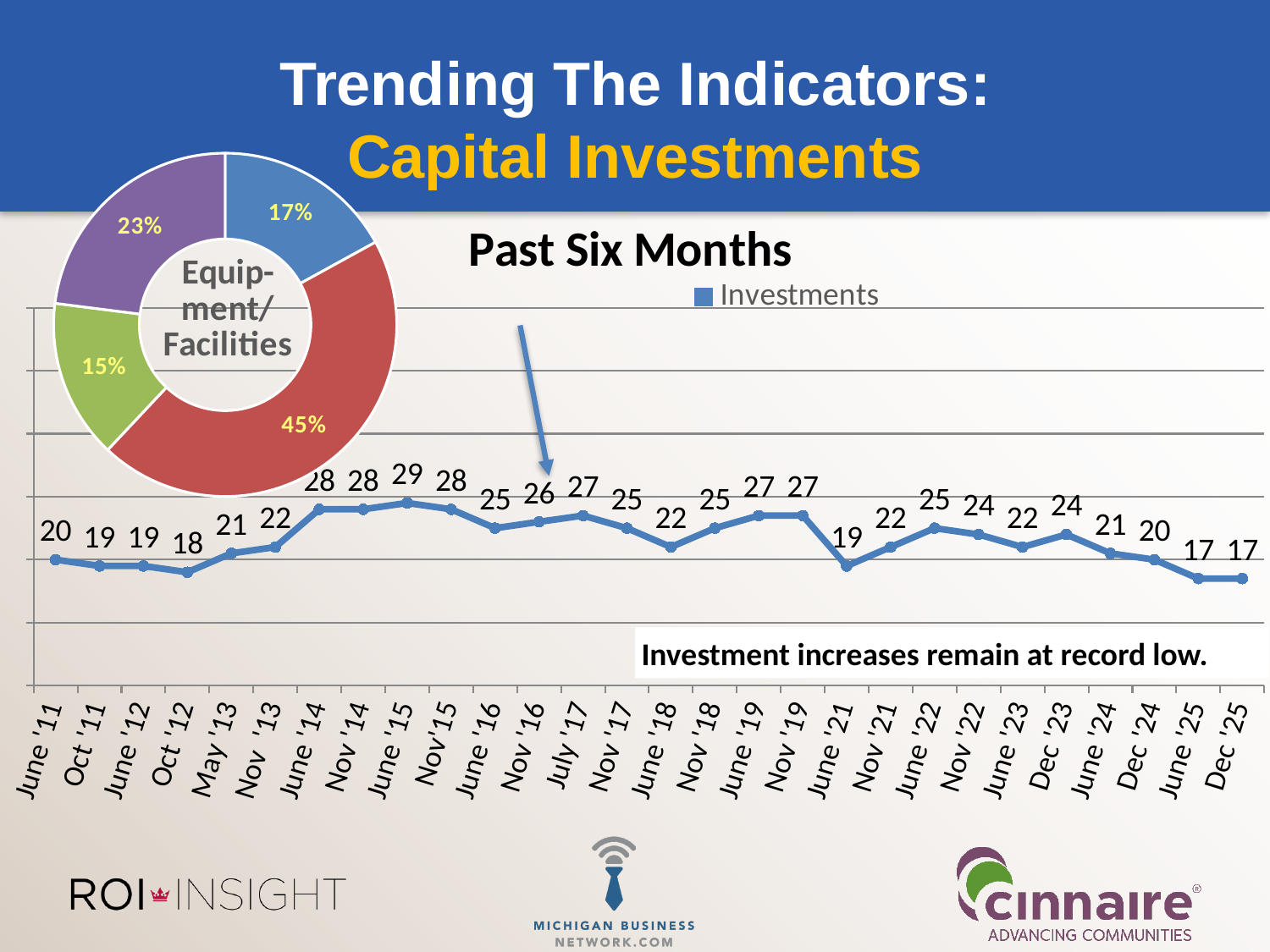
What kind of chart is the Past Six Months chart? Line chart In the Equipment/Facilities donut chart, what is the share of the largest slice? 45% In the Past Six Months line chart, how many data points are plotted? 28 In the Equipment/Facilities donut chart, what is the share of the smallest slice? 15% In the Past Six Months line chart, what is the value for Dec '25? 17 In the Past Six Months line chart, what is the value for June '15? 29 In the Past Six Months line chart, what is the difference between the values for June '14 and June '25? 11 In the Past Six Months line chart, which period has the highest value? June '15 In the Past Six Months line chart, which is larger, the value for Nov '19 or the value for June '21? Nov '19 In the Past Six Months line chart, how many series does the legend list? 1 In the Past Six Months line chart, do the values rise or fall from June '22 to Dec '25? Fall What is the name of the series shown in the legend of the Past Six Months chart? Investments